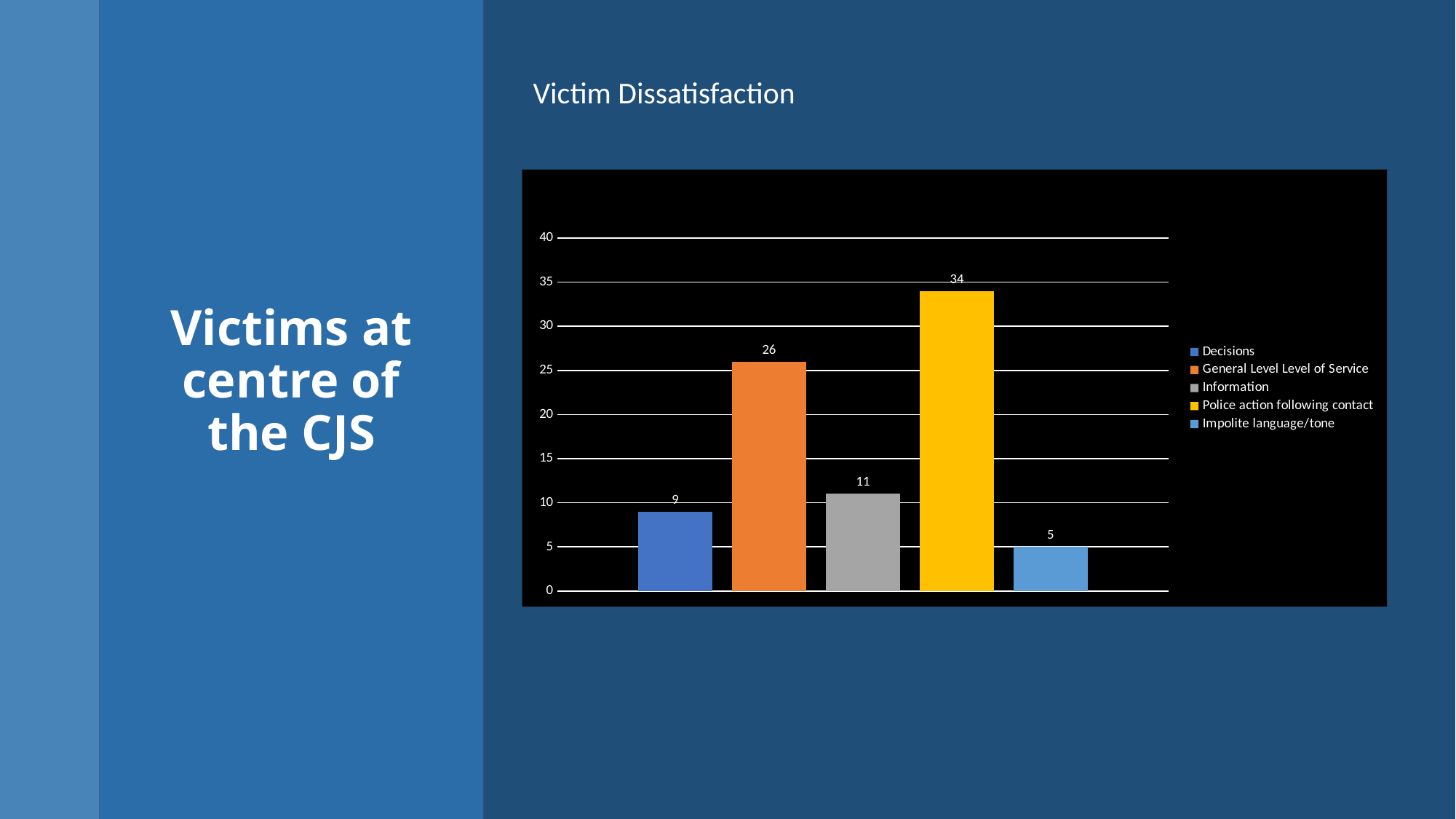
What kind of chart is shown on the slide? Bar chart What is the difference between the values for Police action following contact and General Level Level of Service? 8 What is the value for Impolite language/tone? 5 What is the value for Decisions? 9 How many bars are shown in the chart? 5 Which is larger, the value for Information or the value for Decisions? Information Which category has the highest value? Police action following contact What is the value for Information? 11 Which category has the lowest value? Impolite language/tone What is the value for General Level Level of Service? 26 What is the title of the chart? Victim Dissatisfaction What is the value for Police action following contact? 34